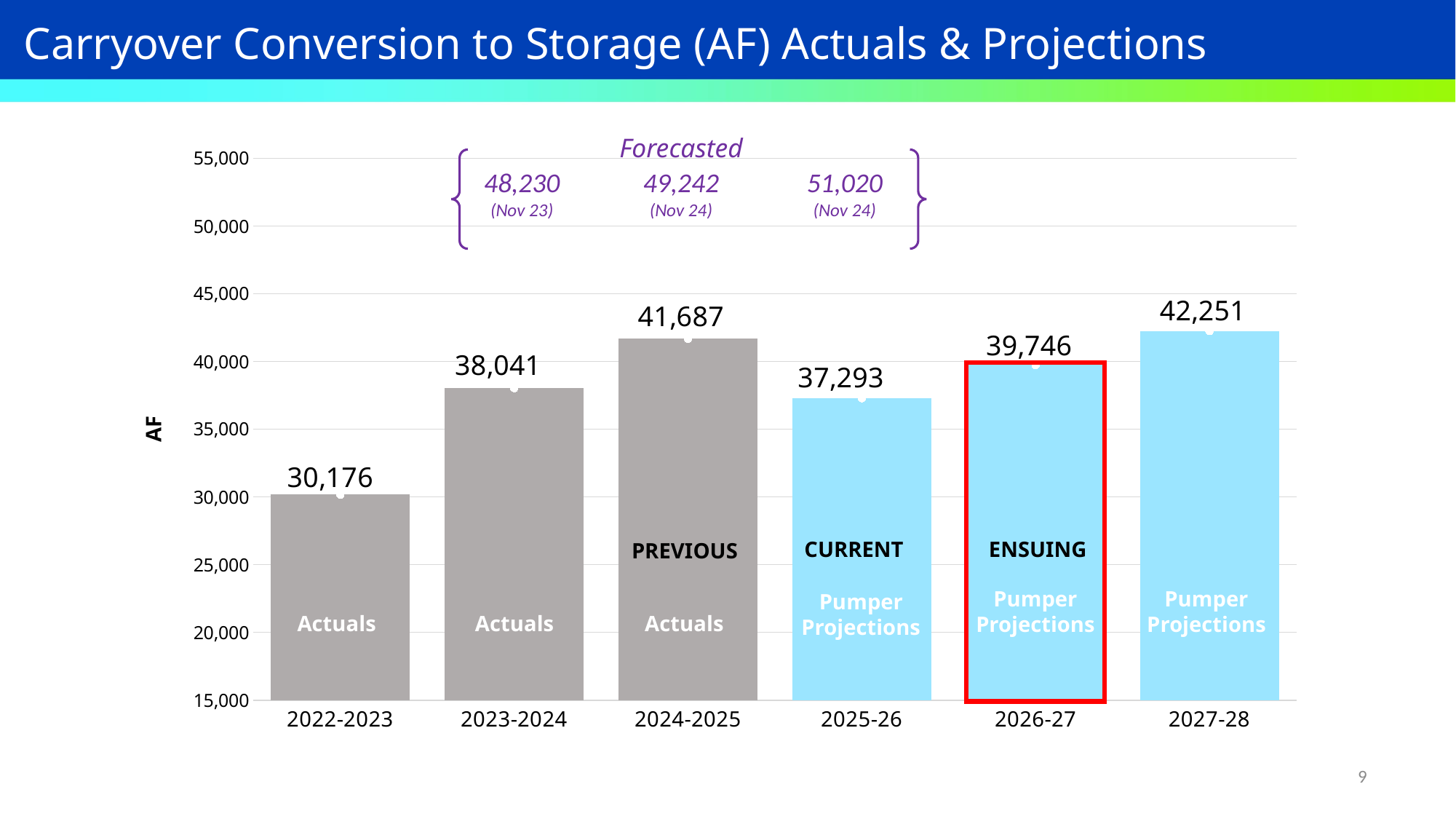
What is the difference between the values for 2023-2024 and 2022-2023? 7,865 Which category is highlighted with a red outline? 2026-27 Is the value for 2025-26 greater or less than 40,000? less What is the difference between the values for 2024-2025 and 2025-26? 4,394 Which is larger, the value for 2026-27 or the value for 2023-2024? 2026-27 Which category has the highest value? 2027-28 What kind of chart is shown on the slide? bar chart What is the value for 2022-2023? 30,176 What is the value for 2026-27? 39,746 Which category has the lowest value? 2022-2023 What is the value for 2024-2025? 41,687 How many categories are shown on the x axis? 6